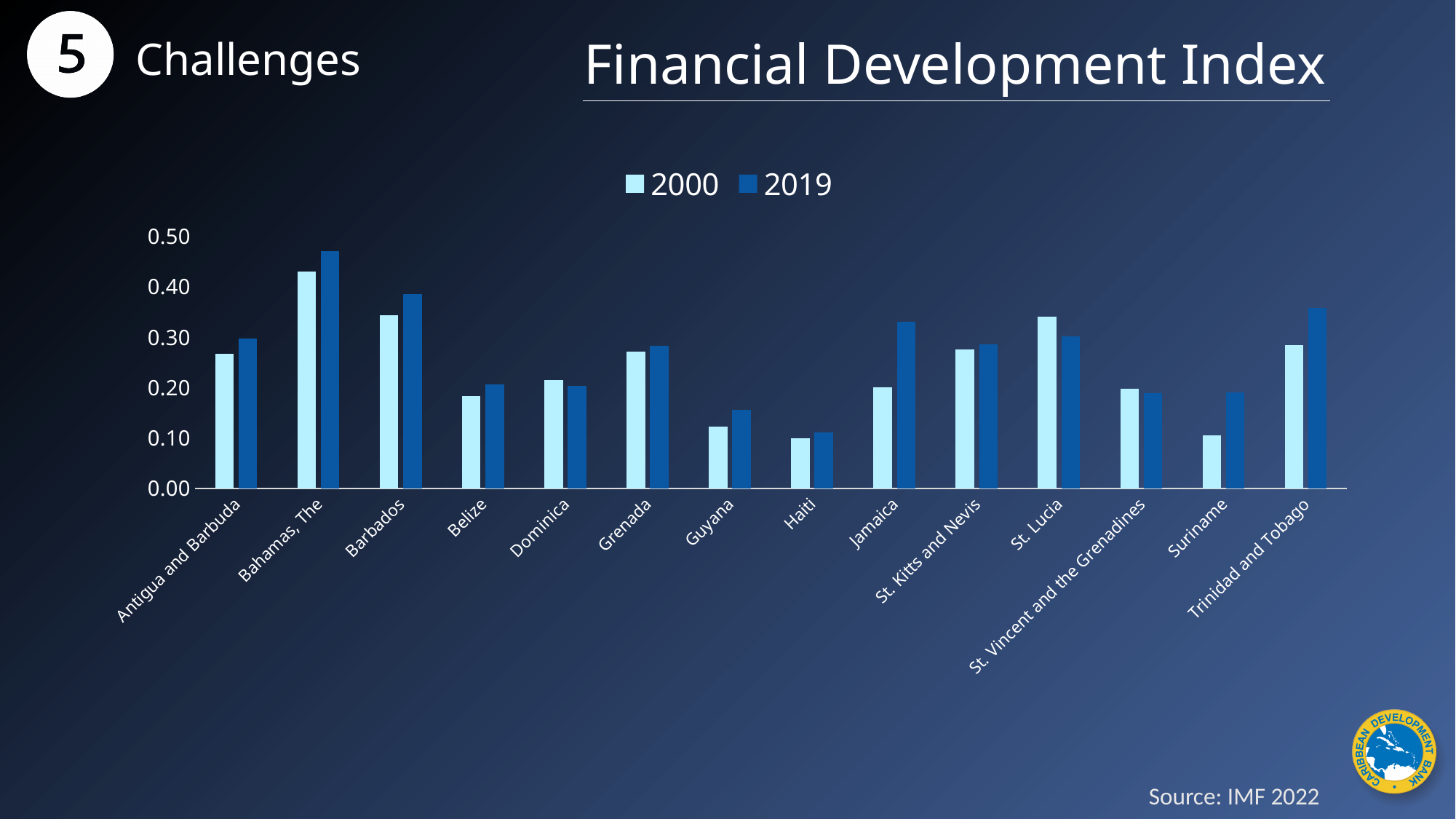
Is the 2019 value for Bahamas, The greater or less than 0.40? greater Is the 2019 value for Jamaica greater or less than 0.30? greater Is the 2000 value for Haiti greater or less than 0.20? less What is the source cited for the chart? IMF 2022 Which country has the lowest Financial Development Index value for 2019? Haiti Which country has the highest Financial Development Index value for 2019? Bahamas, The For St. Lucia, which year has the larger value, 2000 or 2019? 2000 How many countries are shown on the x axis? 14 Which country has the highest Financial Development Index value for 2000? Bahamas, The For Jamaica, which year has the larger value, 2000 or 2019? 2019 What kind of chart is shown on the slide? bar chart How many series does the legend list? 2